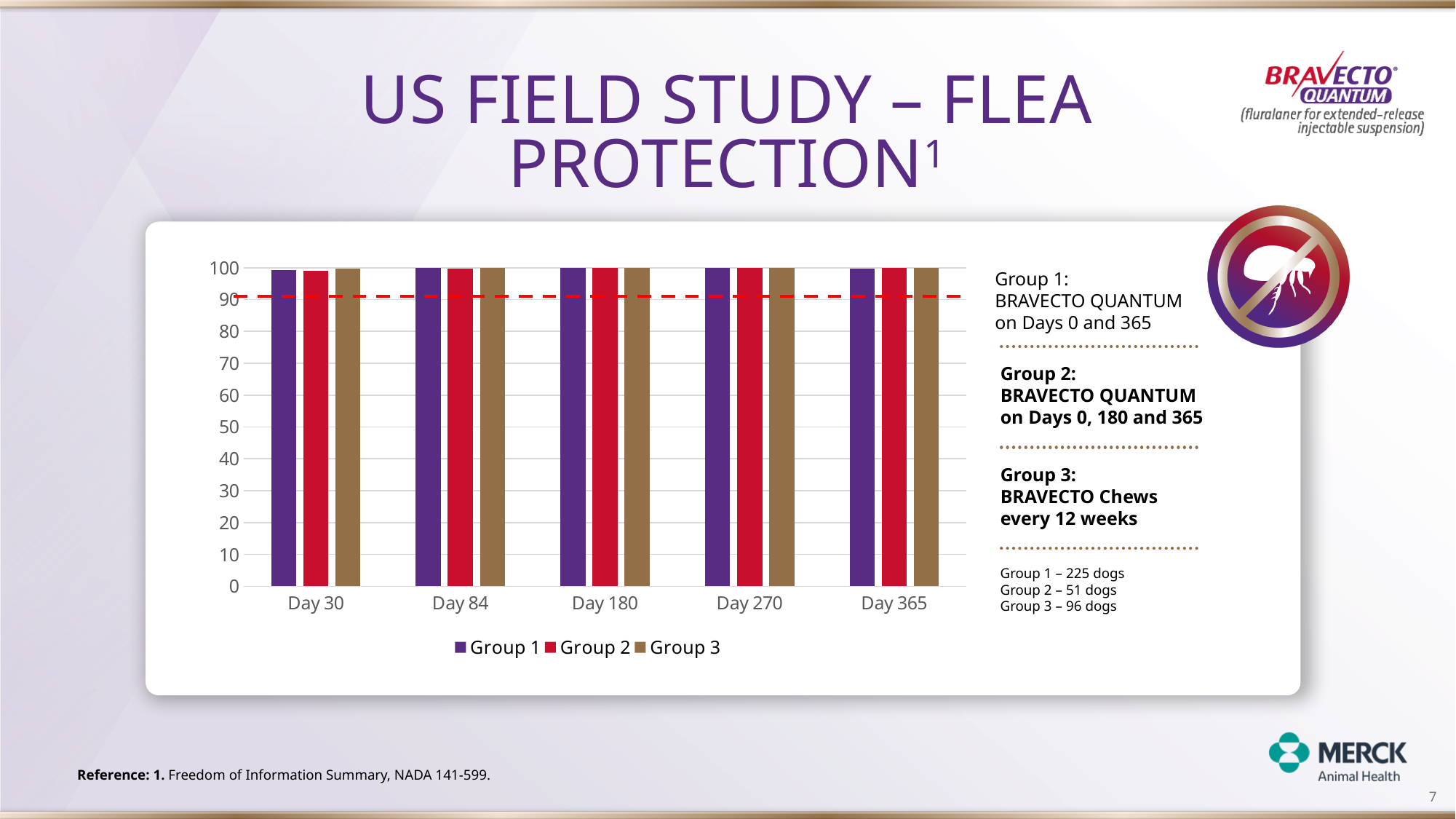
What is the last day category shown on the x axis? Day 365 How many day categories are shown on the x axis of the chart? 5 Is the value for Group 1 at Day 270 greater or less than 50? greater How many series does the chart's legend list? 3 Is the value for Group 3 at Day 365 greater or less than 90? greater What are the three series listed in the chart's legend? Group 1, Group 2, Group 3 At what value on the y axis is the red dashed horizontal line drawn? 90 What kind of chart is shown on the slide? bar chart Is the value for Group 1 at Day 30 greater or less than 90? greater What is the first day category shown on the x axis? Day 30